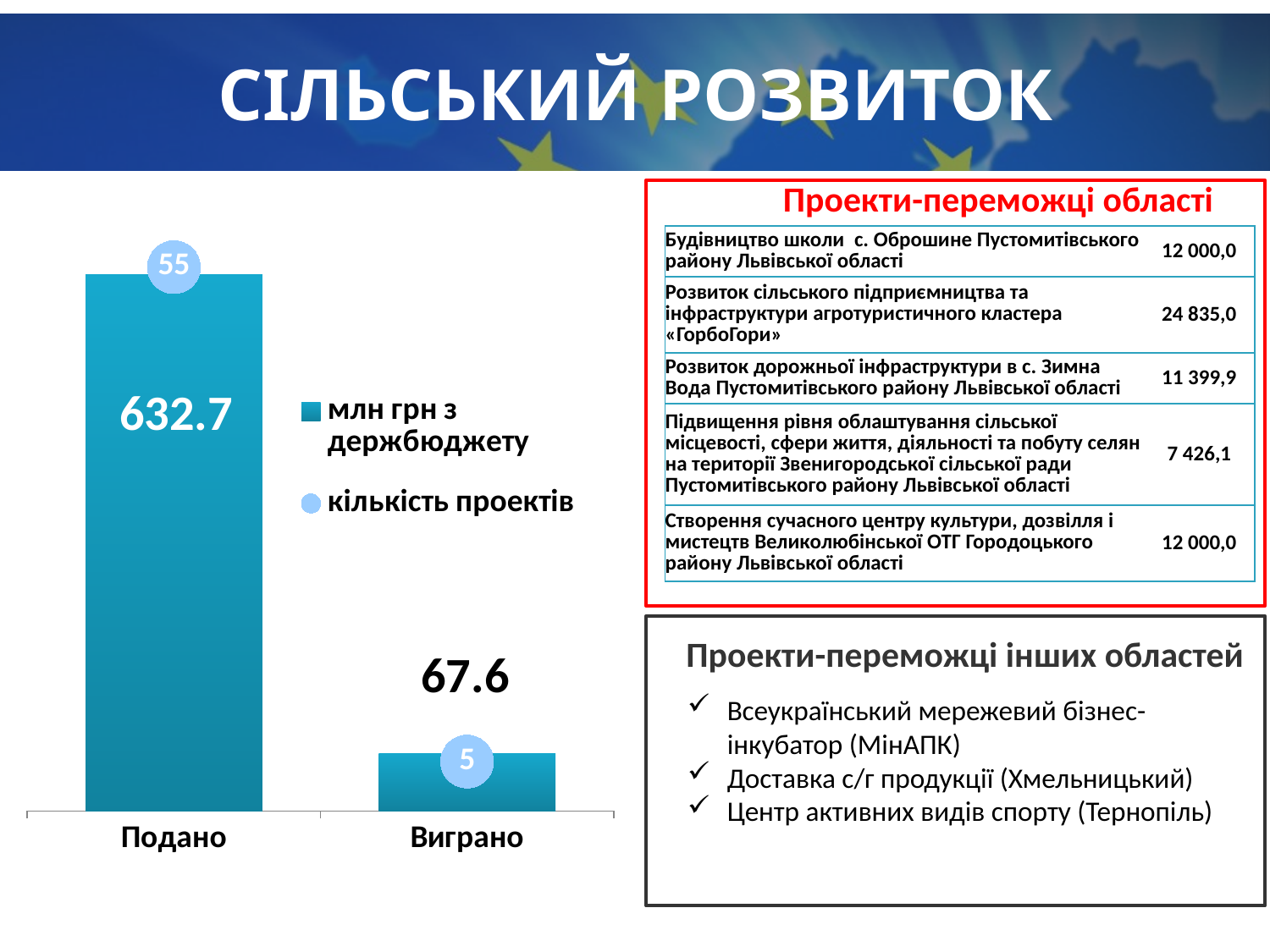
Which category has the lower кількість проектів? Виграно How many categories are shown on the x axis of the chart? 2 What is the difference in кількість проектів between Подано and Виграно? 50 Which category has the higher value in млн грн з держбюджету? Подано What is the value in млн грн з держбюджету for Подано? 632.7 How many series does the chart legend list? 2 What is the кількість проектів for Виграно? 5 Is the млн грн з держбюджету value for Подано larger or smaller than that for Виграно? larger What is the кількість проектів for Подано? 55 What is the difference in млн грн з держбюджету between Подано and Виграно? 565.1 What is the value in млн грн з держбюджету for Виграно? 67.6 What type of chart is shown on the left of the slide? bar chart